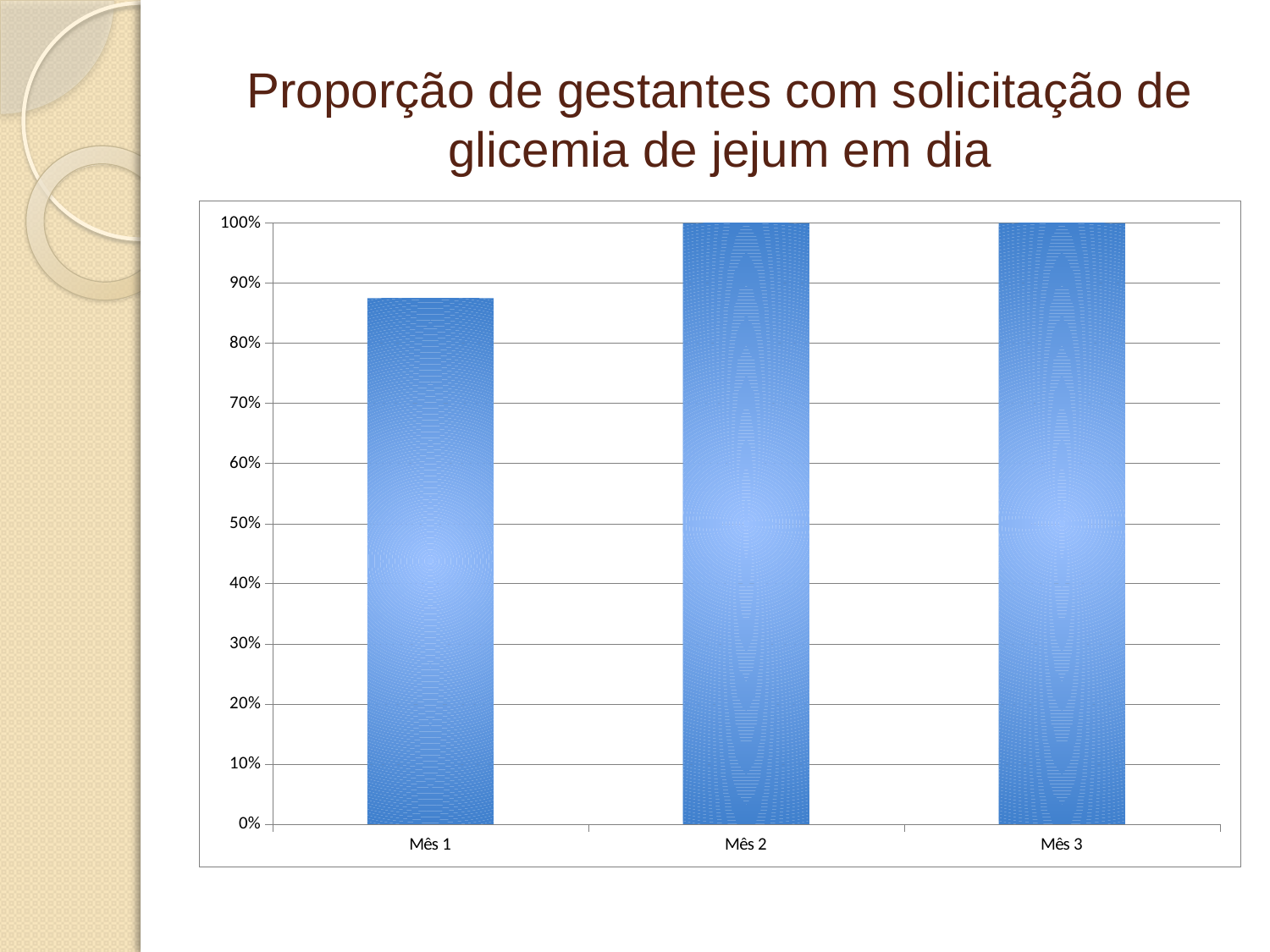
What is the value for Mês 3? 100% What is the highest value shown on the y axis? 100% Which categories reach 100%? Mês 2 and Mês 3 Do the values rise or fall from Mês 1 to Mês 2? rise What is the title of the slide above the chart? Proporção de gestantes com solicitação de glicemia de jejum em dia How many categories are plotted on the x axis? 3 Is the value for Mês 1 greater or less than 80%? greater Is the value for Mês 1 greater or less than 90%? less Which category has the lowest value? Mês 1 Which is larger, the value for Mês 1 or the value for Mês 2? Mês 2 What kind of chart is shown on the slide? bar chart